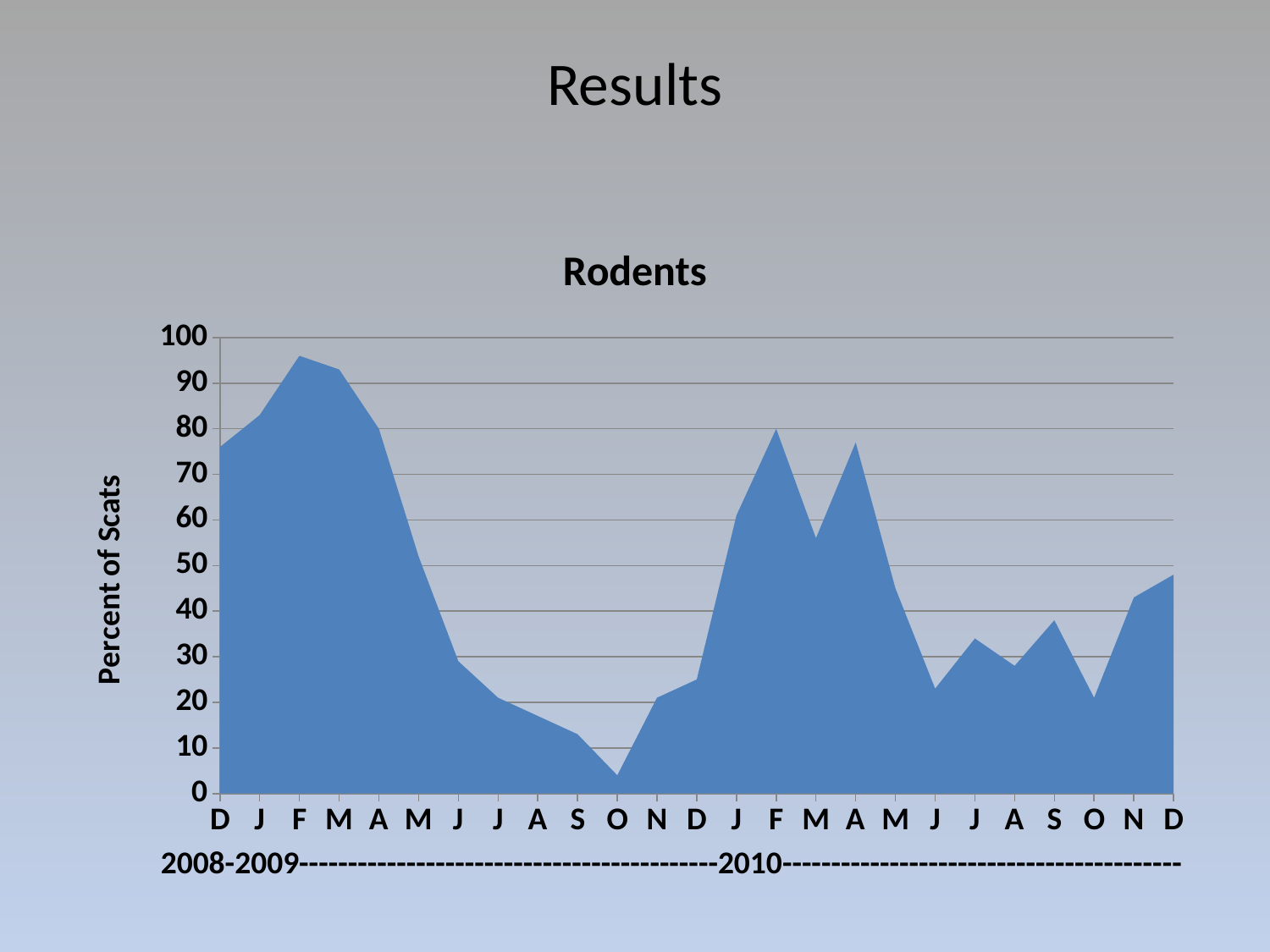
Is the value for the first D (December 2008) greater or less than 70? greater Is the value for the first O (October 2008-2009) greater or less than 10? less Does the percent of scats rise or fall from F (February 2008-2009) to O (October 2008-2009)? fall Is the value for the first F (February 2008-2009) greater or less than 90? greater What is the label on the vertical axis of the chart? Percent of Scats In which month does the percent of scats reach its lowest value? O (October 2008-2009) How many monthly data points are plotted along the x axis? 25 In which month does the percent of scats reach its highest value? F (February 2008-2009) Which is larger, the value for the first F (February 2008-2009) or the second F (February 2010)? the first F (February 2008-2009) What is the title of the chart? Rodents What kind of chart is shown on the slide? area chart